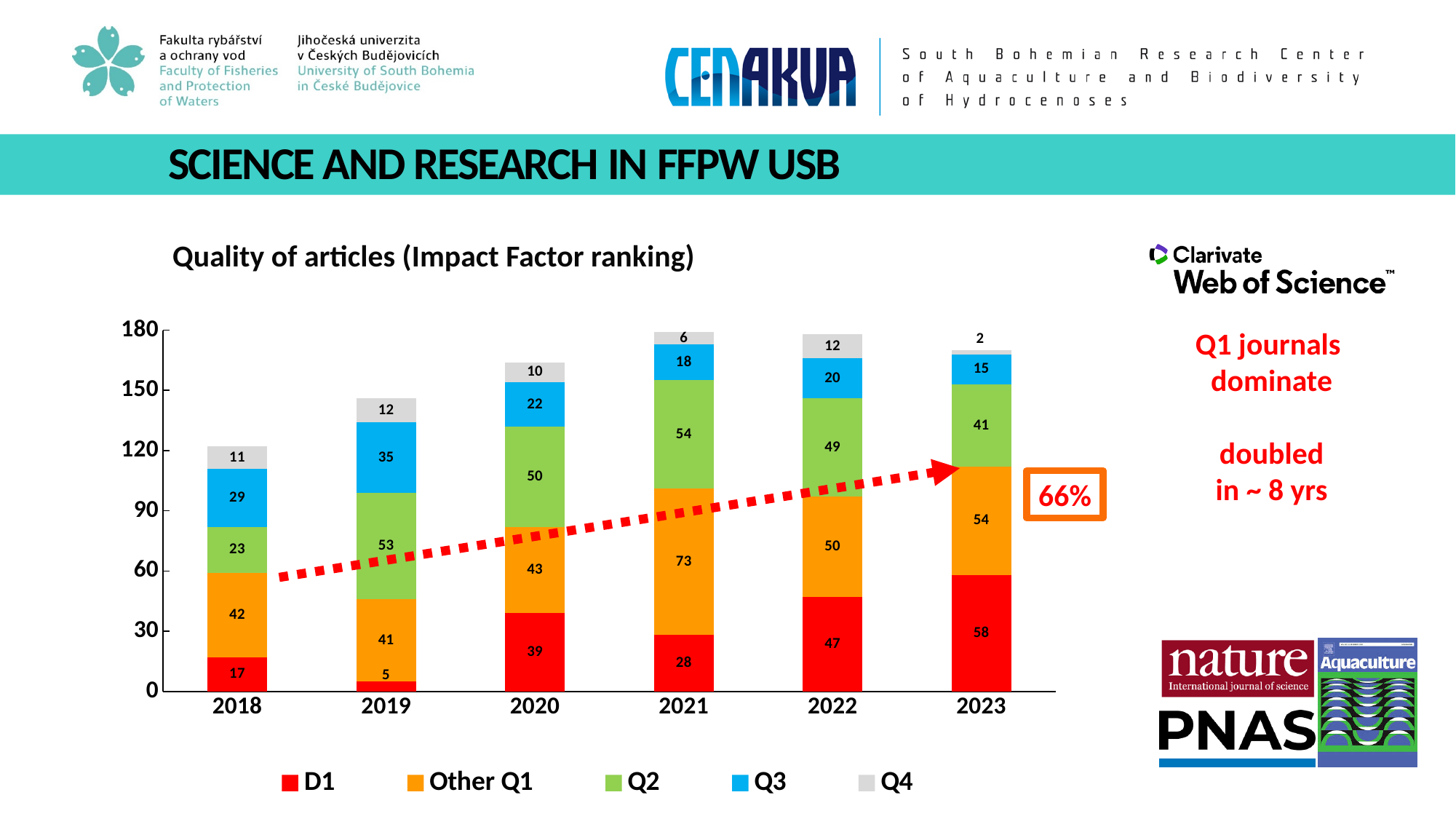
How many series does the legend list? 5 What is the value for Q4 in 2023? 2 Which is larger, the Other Q1 value in 2022 or in 2023? 2023 What is the total of the stacked bar for 2018? 122 How many years are shown on the x axis? 6 What is the value for Q3 in 2019? 35 What is the difference between the Q2 values in 2021 and 2018? 31 What is the value for Other Q1 in 2021? 73 What is the value for D1 in 2023? 58 In which year is the D1 value lowest? 2019 In which year is the D1 value highest? 2023 What kind of chart is shown? Stacked bar chart